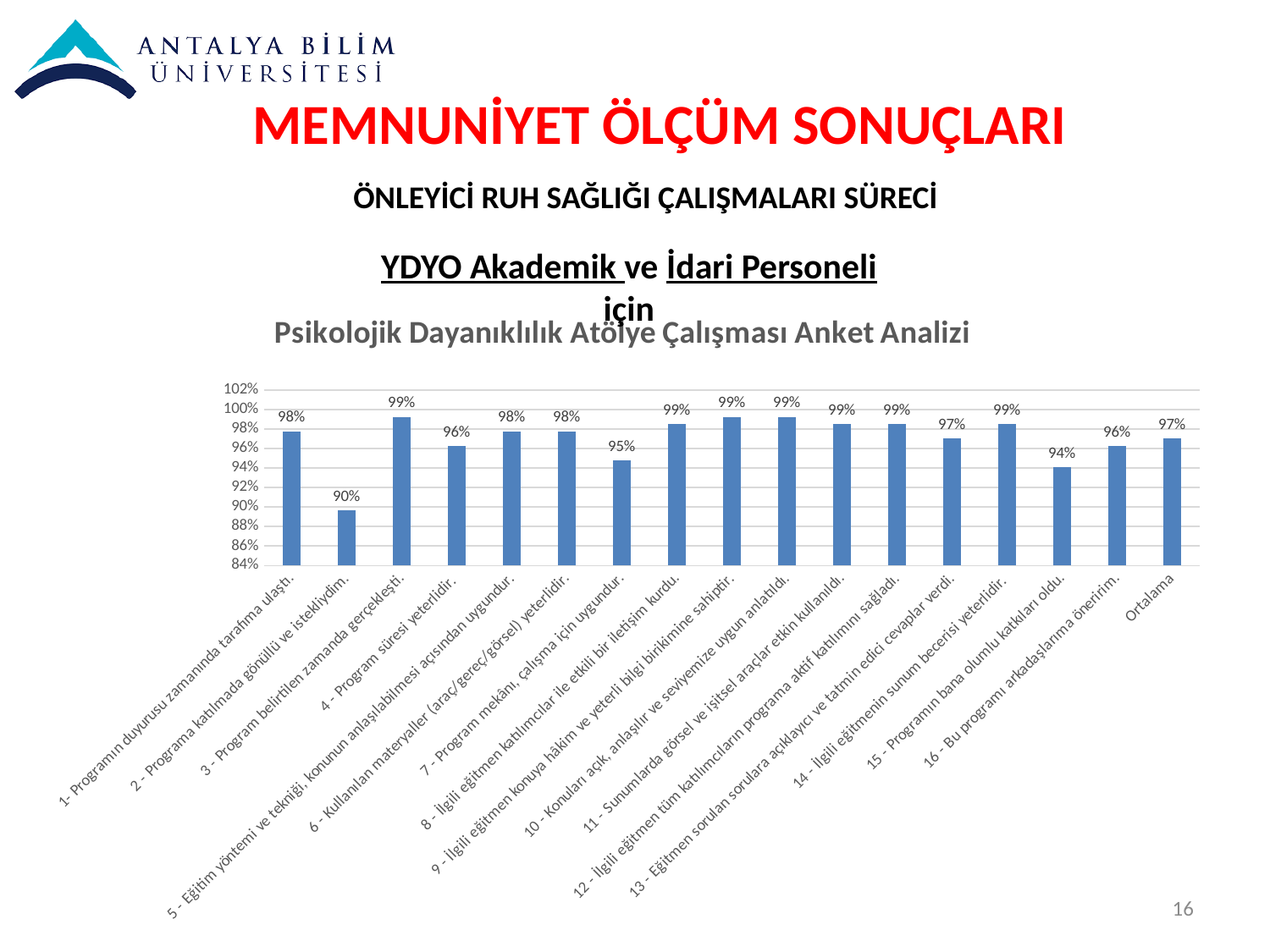
What colour are the bars in the chart? Blue What is the value for "Ortalama"? 97% How many bars are plotted in the chart? 17 Is the value for "2 - Programa katılmada gönüllü ve istekliydim." greater or less than 92%? less What is the value for "7 - Program mekânı, çalışma için uygundur."? 95% What is the value for "15 - Programın bana olumlu katkıları oldu."? 94% Which category has the lowest value? 2 - Programa katılmada gönüllü ve istekliydim. Which is larger, the value for "4 - Program süresi yeterlidir." or the value for "15 - Programın bana olumlu katkıları oldu."? 4 - Program süresi yeterlidir. What is the difference between the values for "3 - Program belirtilen zamanda gerçekleşti." and "2 - Programa katılmada gönüllü ve istekliydim."? 9% What is the title of the chart? Psikolojik Dayanıklılık Atölye Çalışması Anket Analizi What kind of chart is shown on the slide? Bar chart What is the value for "2 - Programa katılmada gönüllü ve istekliydim."? 90%